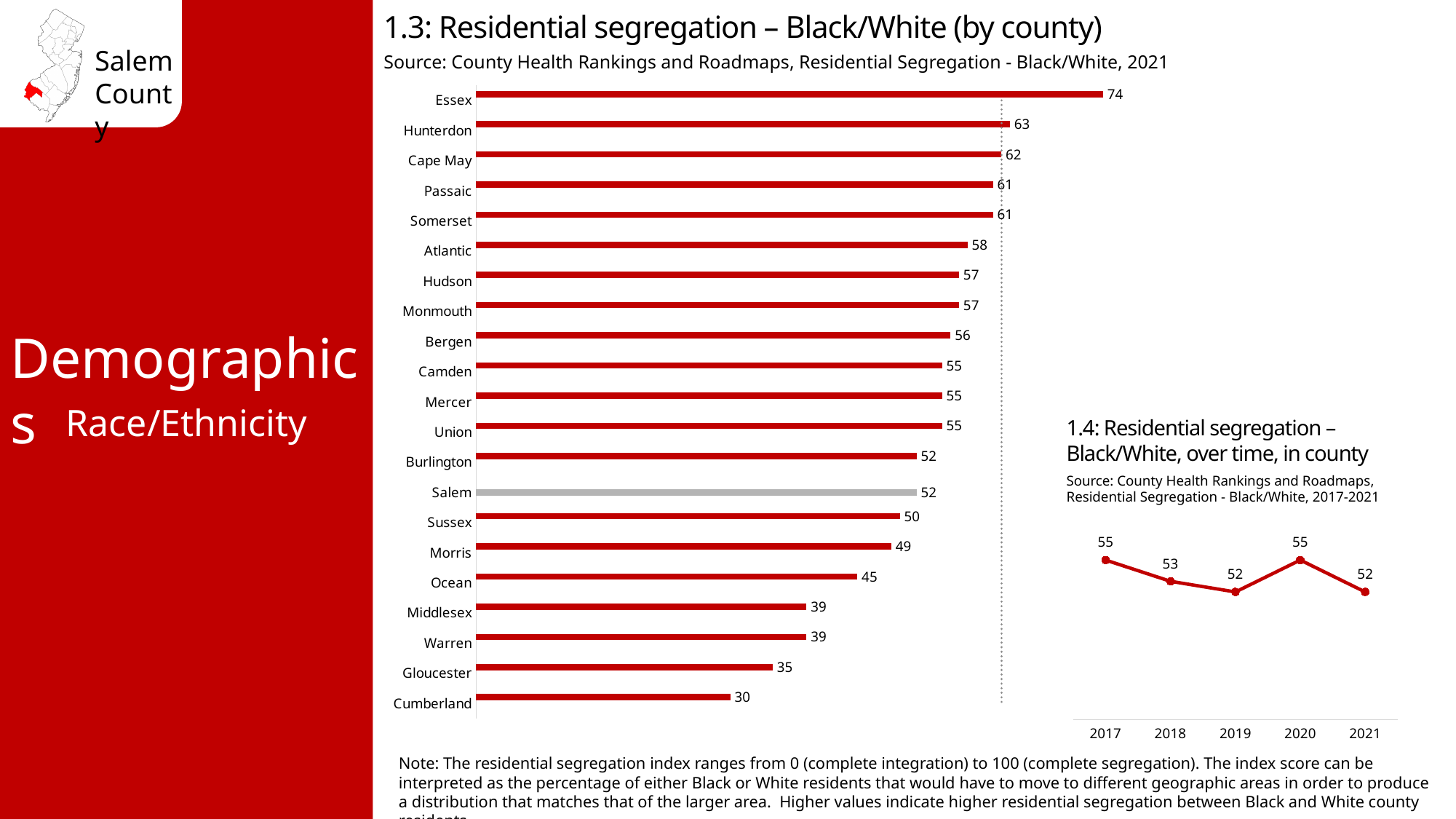
What kind of chart is '1.4: Residential segregation – Black/White, over time, in county'? Line chart In the chart '1.3: Residential segregation – Black/White (by county)', what is the difference between the values for Essex and Cumberland? 44 In the chart '1.3: Residential segregation – Black/White (by county)', which county has the lowest value? Cumberland In the chart '1.3: Residential segregation – Black/White (by county)', which has a larger value, Hunterdon or Atlantic? Hunterdon What kind of chart is '1.3: Residential segregation – Black/White (by county)'? Bar chart In the chart '1.3: Residential segregation – Black/White (by county)', which county has the highest value? Essex In the chart '1.3: Residential segregation – Black/White (by county)', what is the value for Gloucester? 35 In the chart '1.4: Residential segregation – Black/White, over time, in county', what is the difference between the values for 2017 and 2019? 3 In the chart '1.3: Residential segregation – Black/White (by county)', how many counties are shown? 21 In the chart '1.4: Residential segregation – Black/White, over time, in county', what is the value for 2020? 55 In the chart '1.4: Residential segregation – Black/White, over time, in county', how many years are plotted? 5 In the chart '1.3: Residential segregation – Black/White (by county)', what is the value for Salem? 52